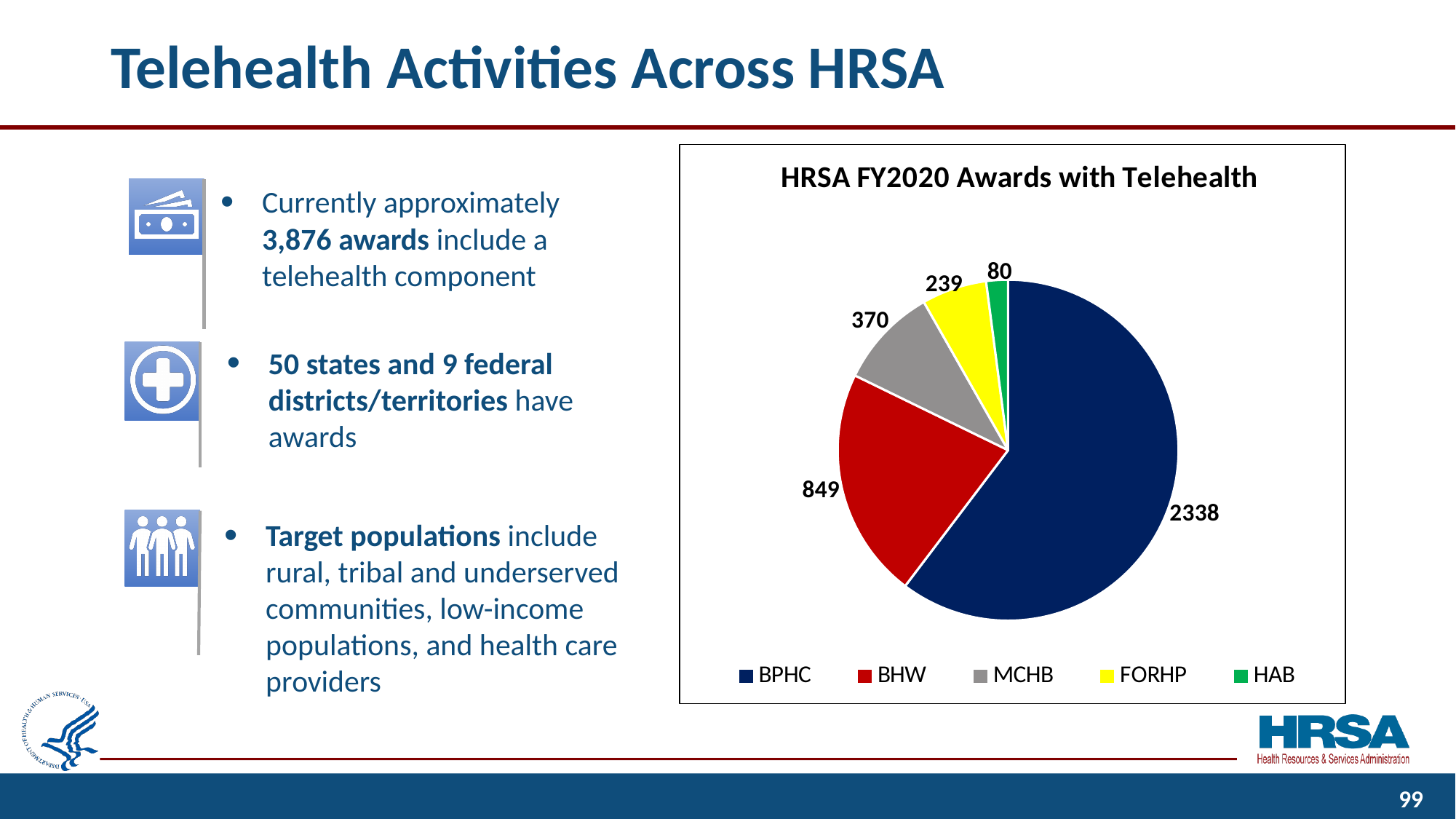
What is the difference between the BPHC and BHW values in the pie chart? 1489 How many categories does the pie chart show? 5 What is the total of all slices in the pie chart? 3876 Which category has the largest slice in the pie chart? BPHC What is the value for HAB in the pie chart? 80 Which category has the smallest slice in the pie chart? HAB What is the value for MCHB in the pie chart? 370 Which is larger in the pie chart, MCHB or FORHP? MCHB What is the title of the pie chart? HRSA FY2020 Awards with Telehealth What is the value for BHW in the pie chart? 849 What type of chart is shown on the slide? pie chart What is the value for BPHC in the HRSA FY2020 Awards with Telehealth chart? 2338